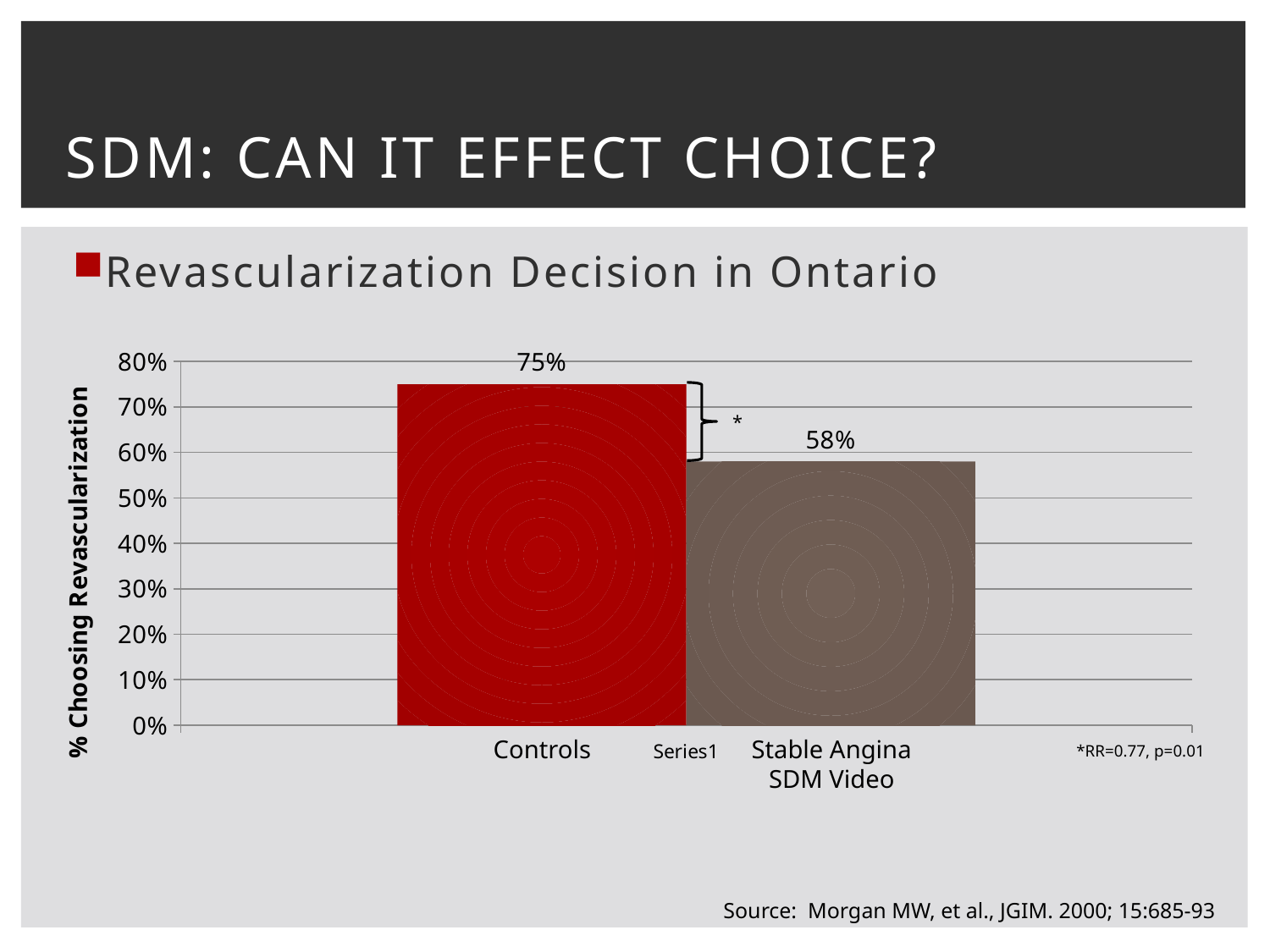
What is the difference in percentage points between Controls and the Stable Angina SDM Video group? 17% What is the label of the vertical axis? % Choosing Revascularization Which group has the lower percentage choosing revascularization? Stable Angina SDM Video Is the value for Controls greater or less than 70%? greater Is the value for Stable Angina SDM Video greater or less than 60%? less What percentage of the Stable Angina SDM Video group chose revascularization? 58% Is the value for Controls greater or less than the value for Stable Angina SDM Video? greater How many bars are shown in the chart? 2 Which group has the higher percentage choosing revascularization? Controls What kind of chart is shown on the slide? bar chart What is the maximum value shown on the vertical axis? 80% What percentage of Controls chose revascularization? 75%